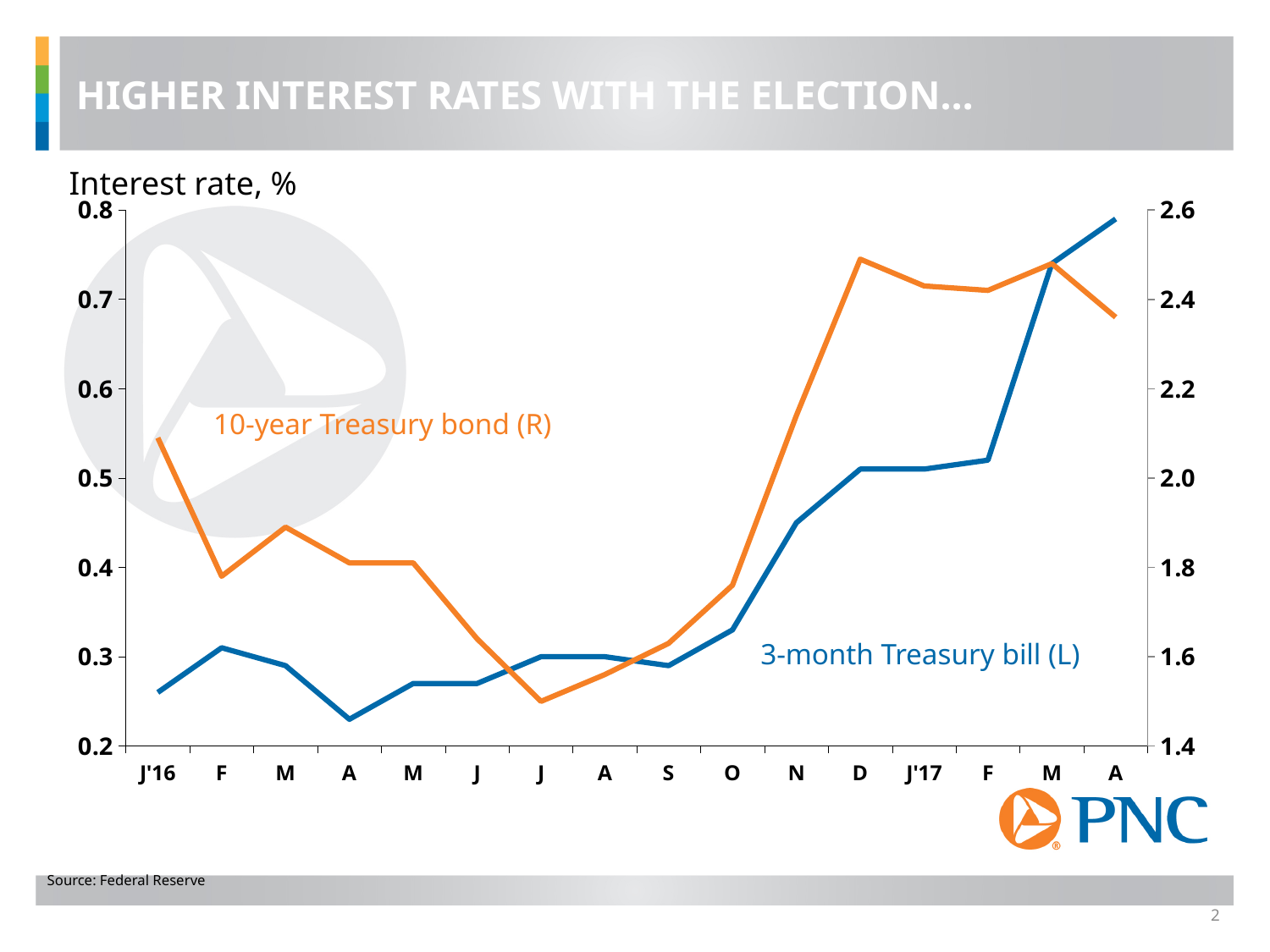
Is the value for the 3-month Treasury bill at A (April 2017) greater or less than 0.7? greater Is the value for the 3-month Treasury bill at A (April 2016) greater or less than 0.3? less What is the title of the chart (the label above the plot area)? Interest rate, % Is the value for the 10-year Treasury bond at D (December 2016) greater or less than 2.4? greater How many series are plotted on the chart? 2 In which month does the 10-year Treasury bond reach its lowest value? J (July 2016) Does the 3-month Treasury bill rise or fall from O (October 2016) to A (April 2017)? rise How many months are labelled along the x axis of the chart? 16 In which month does the 3-month Treasury bill reach its highest value? A (April 2017) Which series is plotted in orange? 10-year Treasury bond (R) What kind of chart is shown on the slide? line chart